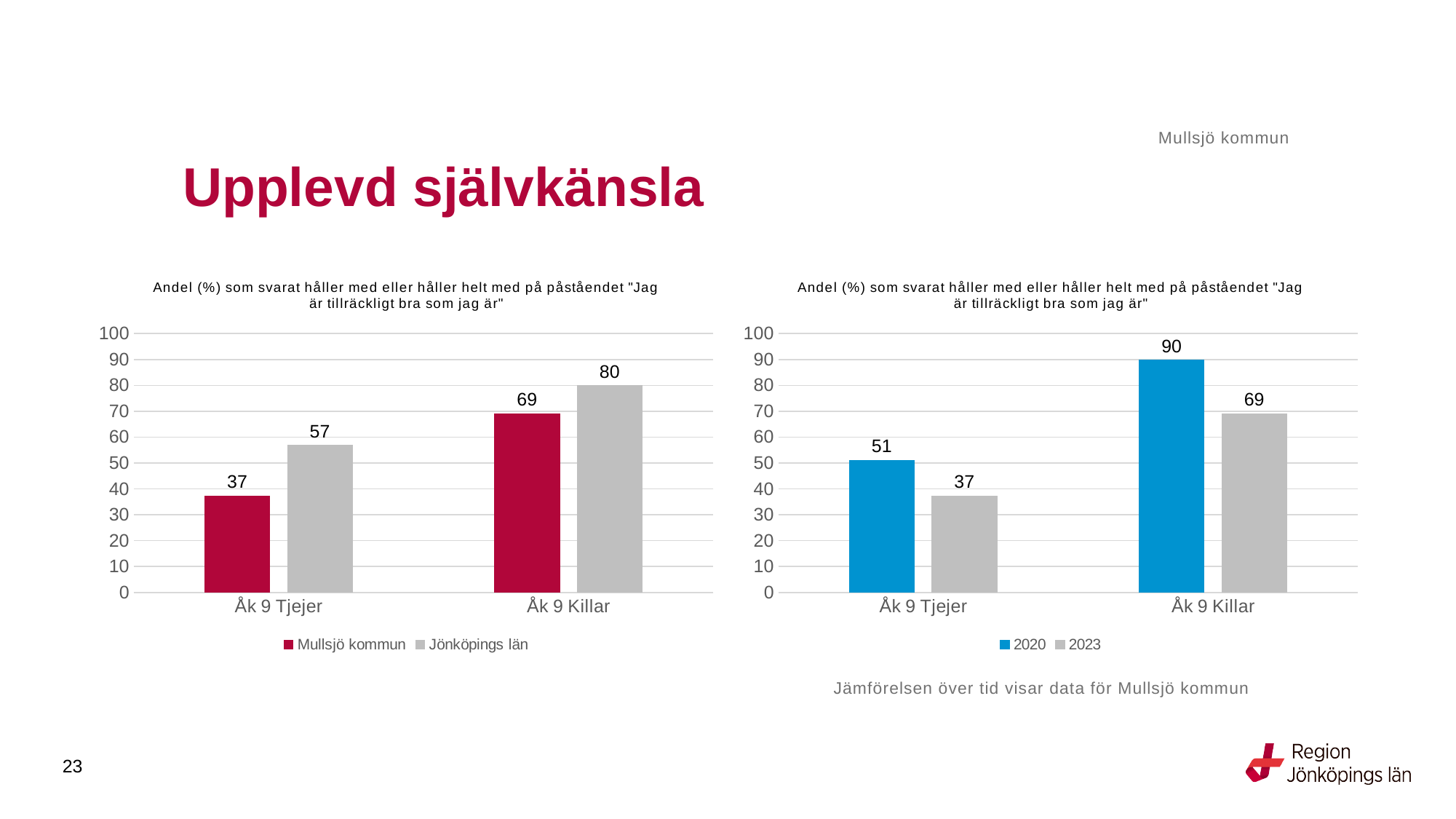
In the right chart, what is the difference between 2020 and 2023 for Åk 9 Killar? 21 In the left chart, what is the value for Mullsjö kommun for Åk 9 Tjejer? 37 What kind of chart is the left chart? Bar chart In the left chart, what is the value for Jönköpings län for Åk 9 Killar? 80 In the right chart, which bar is the highest? 2020, Åk 9 Killar In the right chart, which bar is the lowest? 2023, Åk 9 Tjejer How many series does the legend of the right chart list? 2 In the left chart, which is larger for Åk 9 Killar: Mullsjö kommun or Jönköpings län? Jönköpings län In the left chart, what is the difference between Jönköpings län and Mullsjö kommun for Åk 9 Tjejer? 20 In the right chart, what is the value for 2020 for Åk 9 Killar? 90 In the right chart, what is the value for 2023 for Åk 9 Tjejer? 37 In the left chart, what are the two series listed in the legend? Mullsjö kommun and Jönköpings län